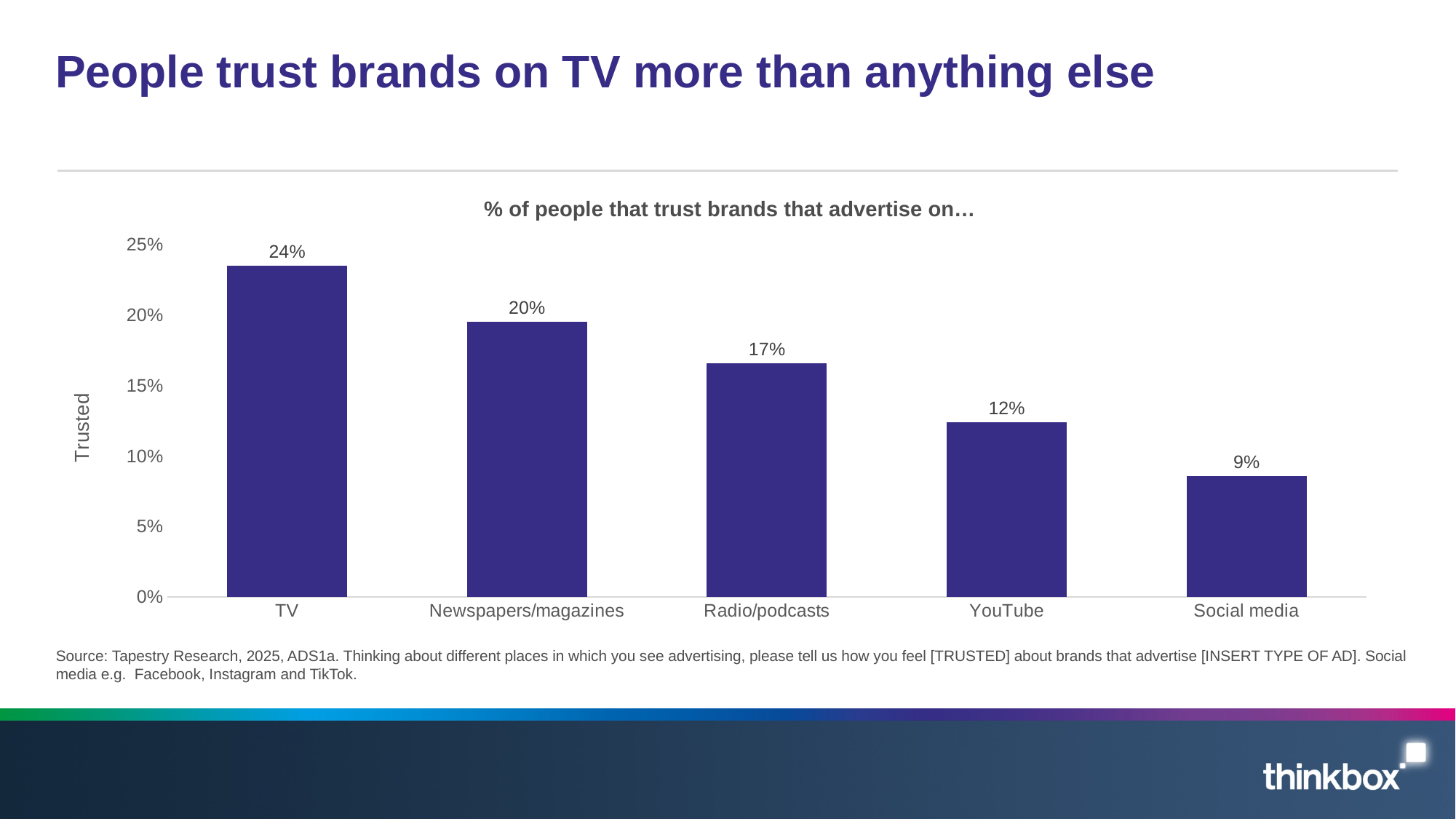
What is the value for Newspapers/magazines? 20% How many categories are shown on the chart? 5 Which is larger, the value for Radio/podcasts or the value for YouTube? Radio/podcasts What is the title of the chart? % of people that trust brands that advertise on… Which category has the highest value? TV What is the difference between the values for TV and Social media? 15% What percentage of people trust brands that advertise on Radio/podcasts? 17% What percentage of people trust brands that advertise on TV? 24% Which category has the lowest value? Social media What kind of chart is shown on the slide? Bar chart What is the value shown for Social media? 9% What is the value shown for YouTube? 12%